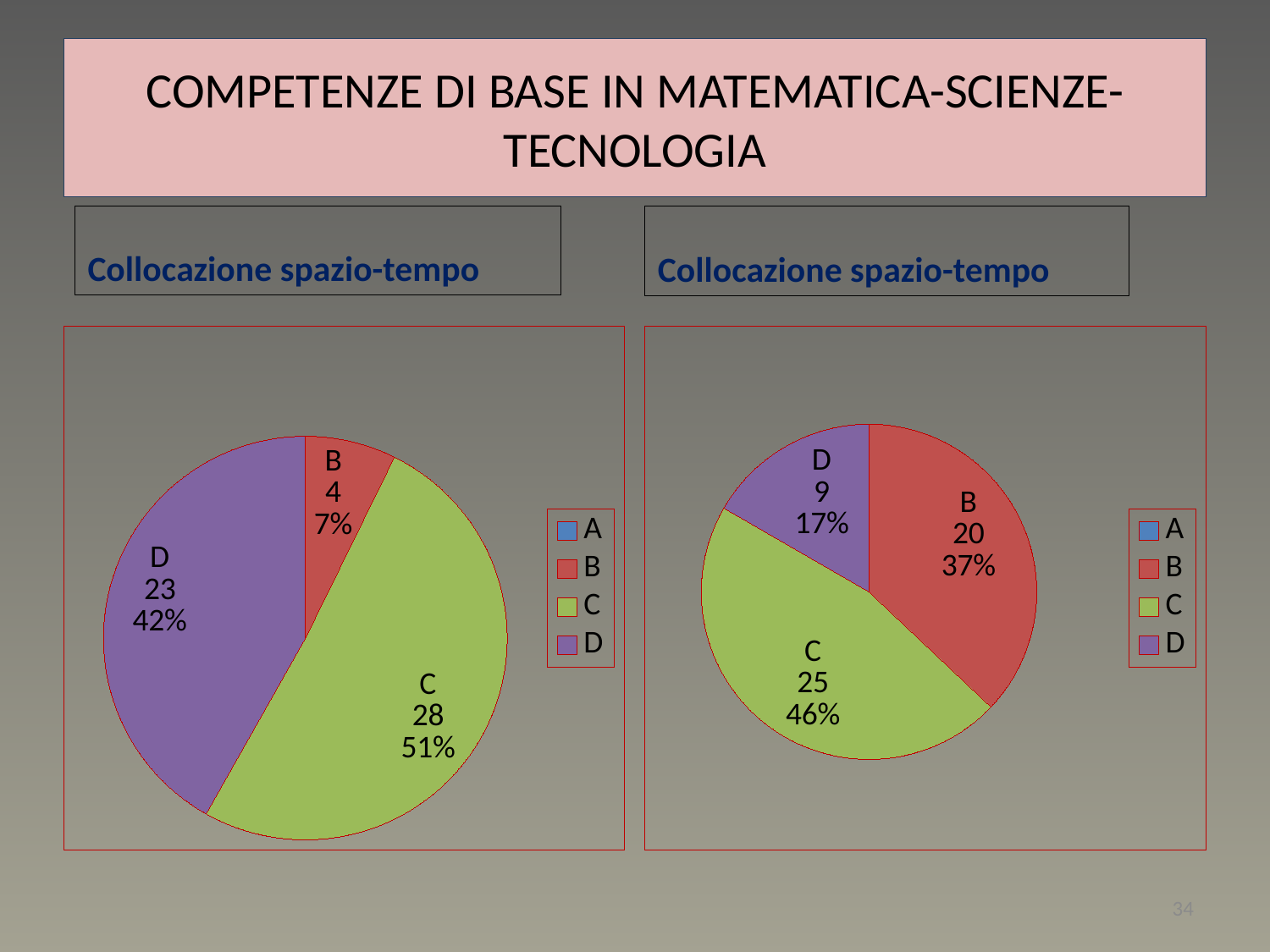
In the right pie chart, what value is shown for category D? 9 In the left pie chart, what value is shown for category C? 28 In the left pie chart, what share of the pie does category D represent? 42% In the left pie chart, which category has the largest slice? C What type of chart is shown on the left side of the slide? Pie chart In the right pie chart, what percentage is shown for category B? 37% How many entries does the legend of the right chart list? 4 In the right pie chart, which category has the smallest slice? D In the right pie chart, which is larger, the value for C or the value for B? C How many slices with data labels does the left pie chart have? 3 In the left pie chart, what is the difference between the values for D and B? 19 What is the title shown above the right chart? Collocazione spazio-tempo